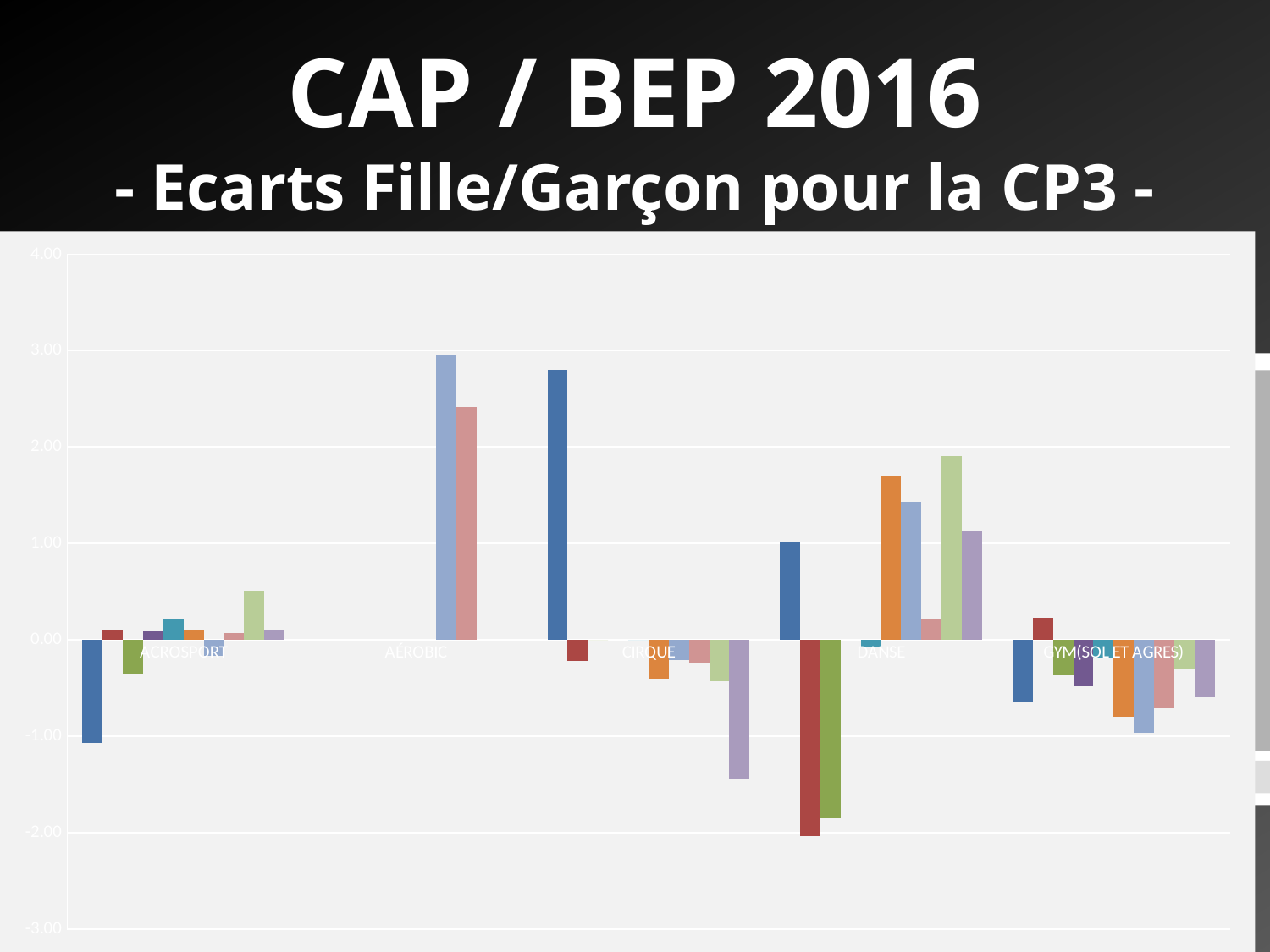
How many categories are shown along the x axis of the chart? 5 What kind of chart is shown on the slide? bar chart Which category contains the tallest bar on the chart? AÉROBIC Is the lowest bar in the CIRQUE category greater or less than -1.00? less Is the tallest bar in the ACROSPORT category greater or less than 1.00? less What is the title shown above the chart? CAP / BEP 2016 - Ecarts Fille/Garçon pour la CP3 - Which category contains the lowest (most negative) bar on the chart? DANSE Which category has the taller maximum bar, AÉROBIC or DANSE? AÉROBIC Is the tallest bar in the DANSE category greater or less than 1.00? greater What is the highest value shown on the vertical axis of the chart? 4.00